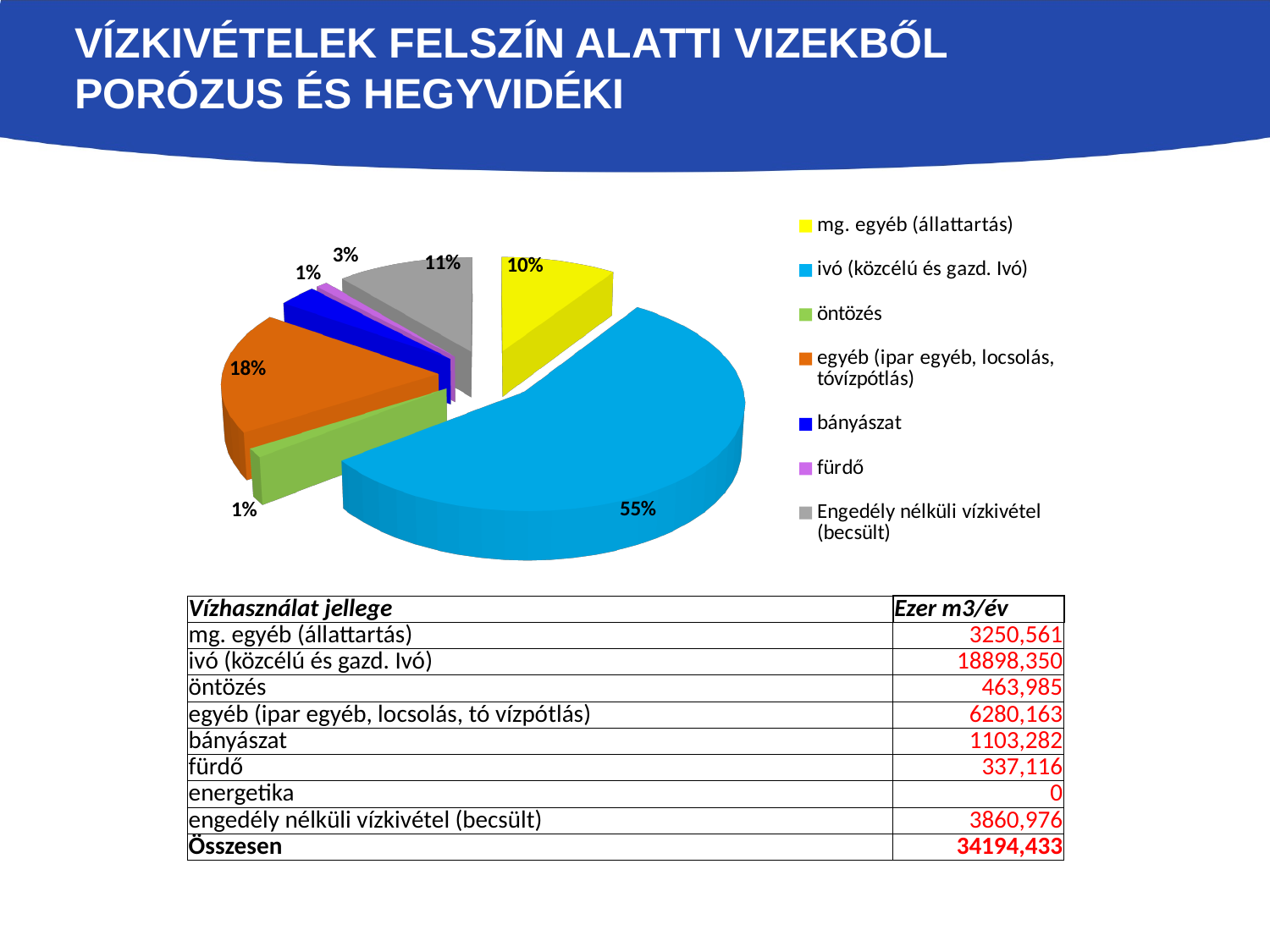
Which category has the largest slice of the pie? ivó (közcélú és gazd. Ivó) What share of the pie does ivó (közcélú és gazd. Ivó) represent? 55% What percentage is shown for öntözés? 1% What is the difference in percentage points between the ivó (közcélú és gazd. Ivó) slice and the egyéb (ipar egyéb, locsolás, tóvízpótlás) slice? 37 What percentage is shown for Engedély nélküli vízkivétel (becsült)? 11% What percentage is shown for mg. egyéb (állattartás)? 10% How many entries does the chart legend list? 7 What percentage is shown for egyéb (ipar egyéb, locsolás, tóvízpótlás)? 18% What kind of chart is shown on the slide? pie chart Which slice is larger: egyéb (ipar egyéb, locsolás, tóvízpótlás) or mg. egyéb (állattartás)? egyéb (ipar egyéb, locsolás, tóvízpótlás) What colour is the slice for ivó (közcélú és gazd. Ivó)? blue Which slice is larger: bányászat or fürdő? bányászat